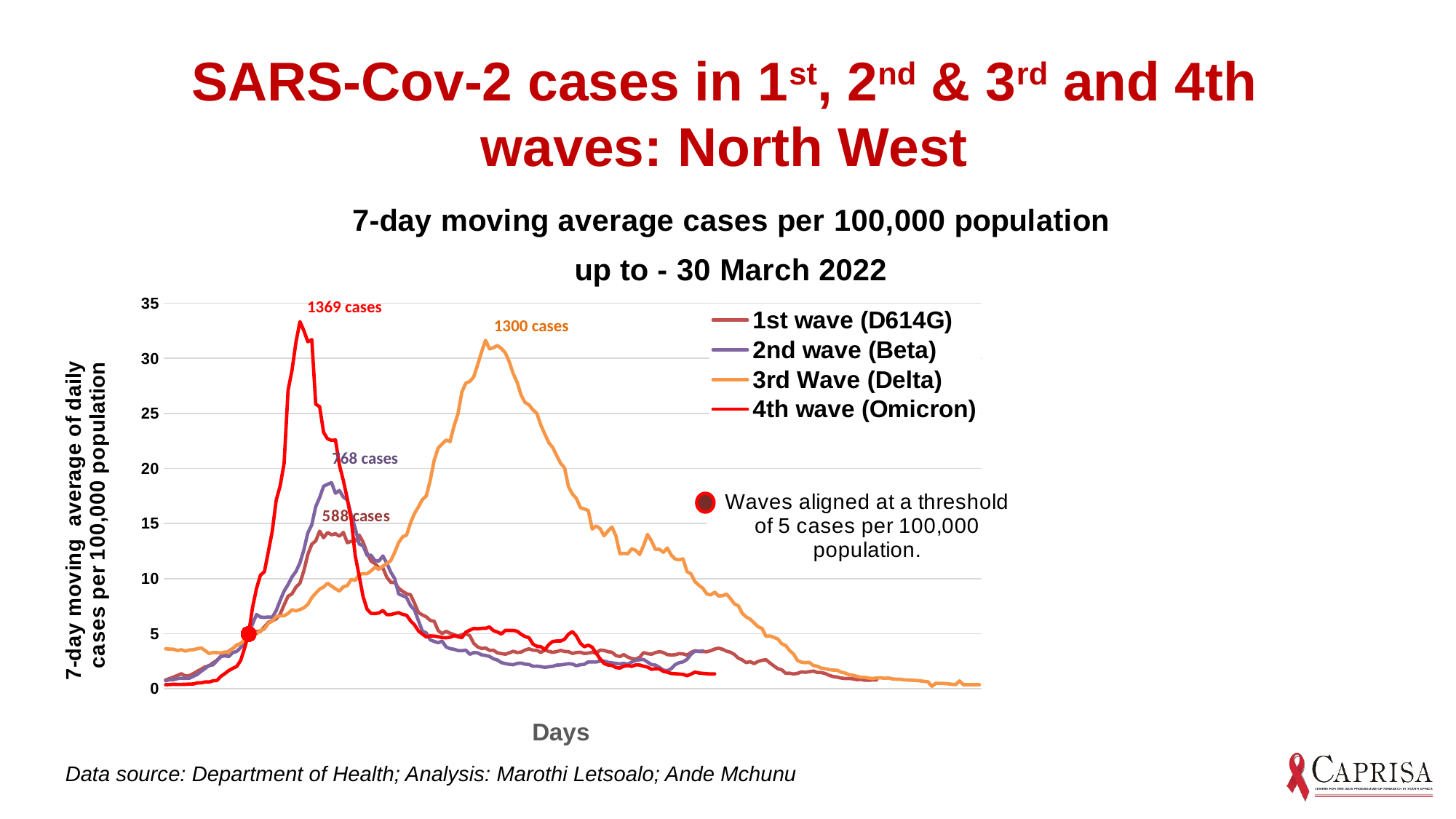
At what threshold of cases per 100,000 population are the waves aligned? 5 cases per 100,000 population How many peak cases are labelled for the 1st wave (D614G)? 588 cases Which wave has the highest labelled peak case count? 4th wave (Omicron) Is the peak of the 1st wave (D614G) line greater or less than 15 cases per 100,000? less Is the peak of the 4th wave (Omicron) line greater or less than 30 cases per 100,000? greater How many peak cases are labelled for the 4th wave (Omicron)? 1369 cases What is the difference between the labelled peak case counts of the 4th wave and the 3rd wave? 69 cases Which wave has the lowest labelled peak case count? 1st wave (D614G) What kind of chart is shown on the slide? line chart How many peak cases are labelled for the 3rd Wave (Delta)? 1300 cases How many series does the legend list? 4 How many peak cases are labelled for the 2nd wave (Beta)? 768 cases